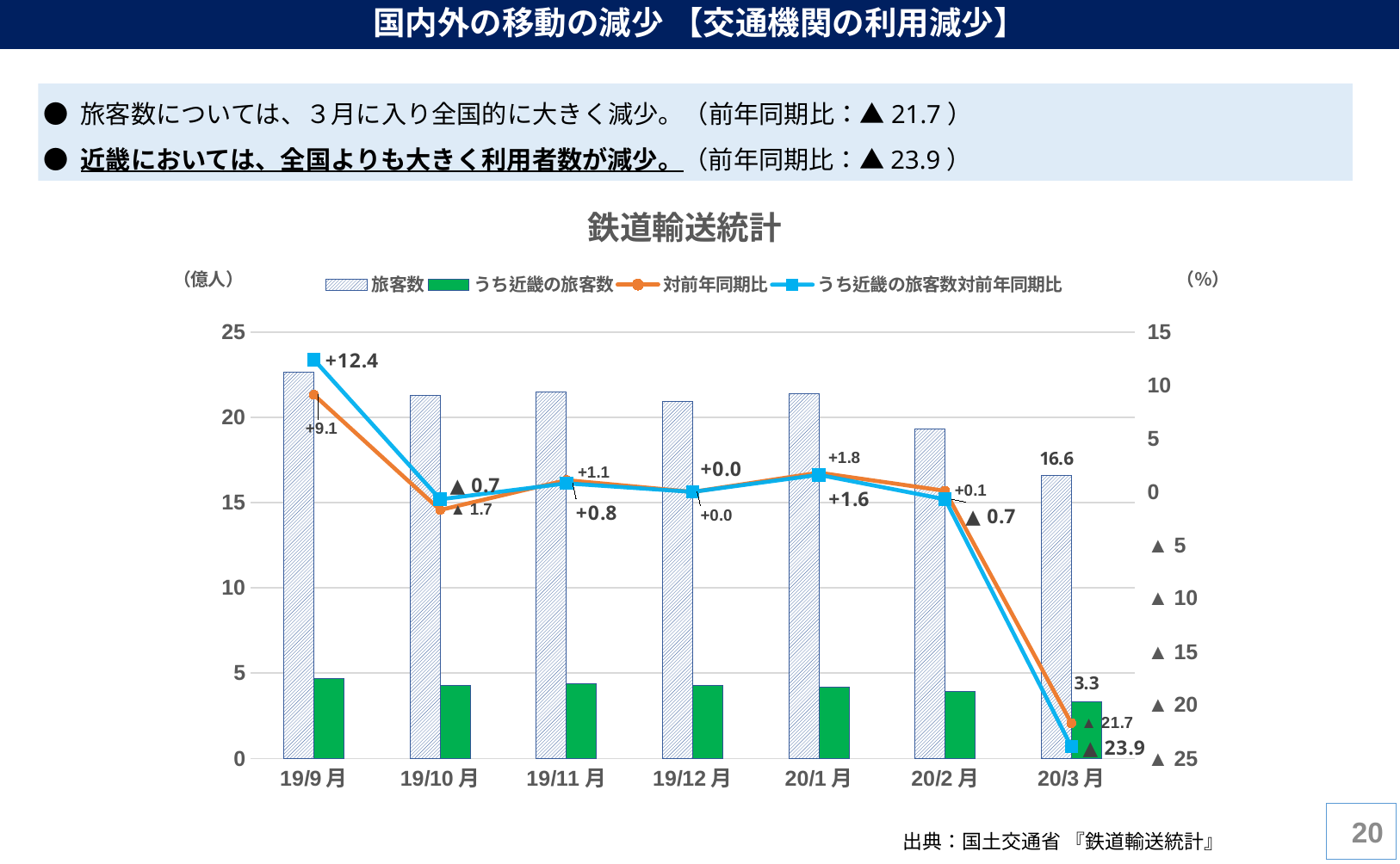
In the 鉄道輸送統計 chart, which month has the lowest 旅客数? 20/3月 How many months are shown on the x axis of the 鉄道輸送統計 chart? 7 In the 鉄道輸送統計 chart, what is the 対前年同期比 value for 20/3月? ▲ 21.7 In the 鉄道輸送統計 chart, what is the 対前年同期比 value for 19/9月? +9.1 In the 鉄道輸送統計 chart, which month has the highest うち近畿の旅客数対前年同期比? 19/9月 In the 鉄道輸送統計 chart, what is the うち近畿の旅客数対前年同期比 value for 20/3月? ▲ 23.9 In the 鉄道輸送統計 chart, what is the うち近畿の旅客数対前年同期比 value for 19/9月? +12.4 In the 鉄道輸送統計 chart, what is the difference between 旅客数 and うち近畿の旅客数 for 20/3月? 13.3 In the 鉄道輸送統計 chart, is the 旅客数 value for 19/9月 greater or less than 20? greater In the 鉄道輸送統計 chart, what is the 旅客数 value for 20/3月? 16.6 In the 鉄道輸送統計 chart, what is the うち近畿の旅客数 value for 20/3月? 3.3 How many series does the legend of the 鉄道輸送統計 chart list? 4